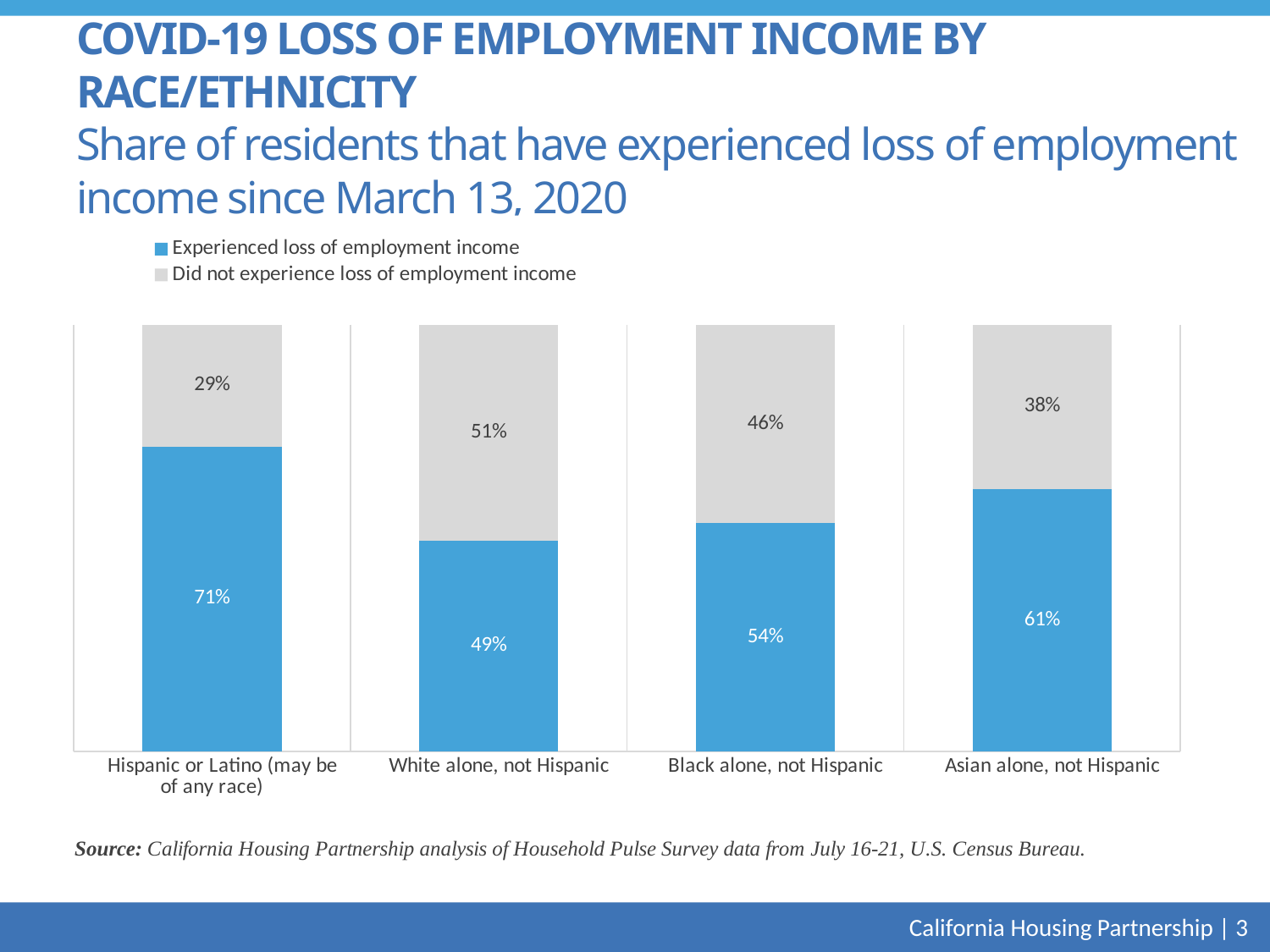
What colour represents residents who experienced loss of employment income? Blue What share of Black alone, not Hispanic residents experienced loss of employment income? 54% What share of White alone, not Hispanic residents did not experience loss of employment income? 51% What share of Hispanic or Latino residents experienced loss of employment income? 71% Which group has the lowest share that experienced loss of employment income? White alone, not Hispanic What share of Asian alone, not Hispanic residents did not experience loss of employment income? 38% How many race/ethnicity groups are shown in the chart? 4 What is the difference between the share of Hispanic or Latino residents and White alone, not Hispanic residents who experienced loss of employment income? 22 percentage points What kind of chart is shown on the slide? Stacked bar chart Which group has a larger share that experienced loss of employment income: Black alone, not Hispanic or Asian alone, not Hispanic? Asian alone, not Hispanic How many series does the legend list? 2 Which group has the highest share that experienced loss of employment income? Hispanic or Latino (may be of any race)